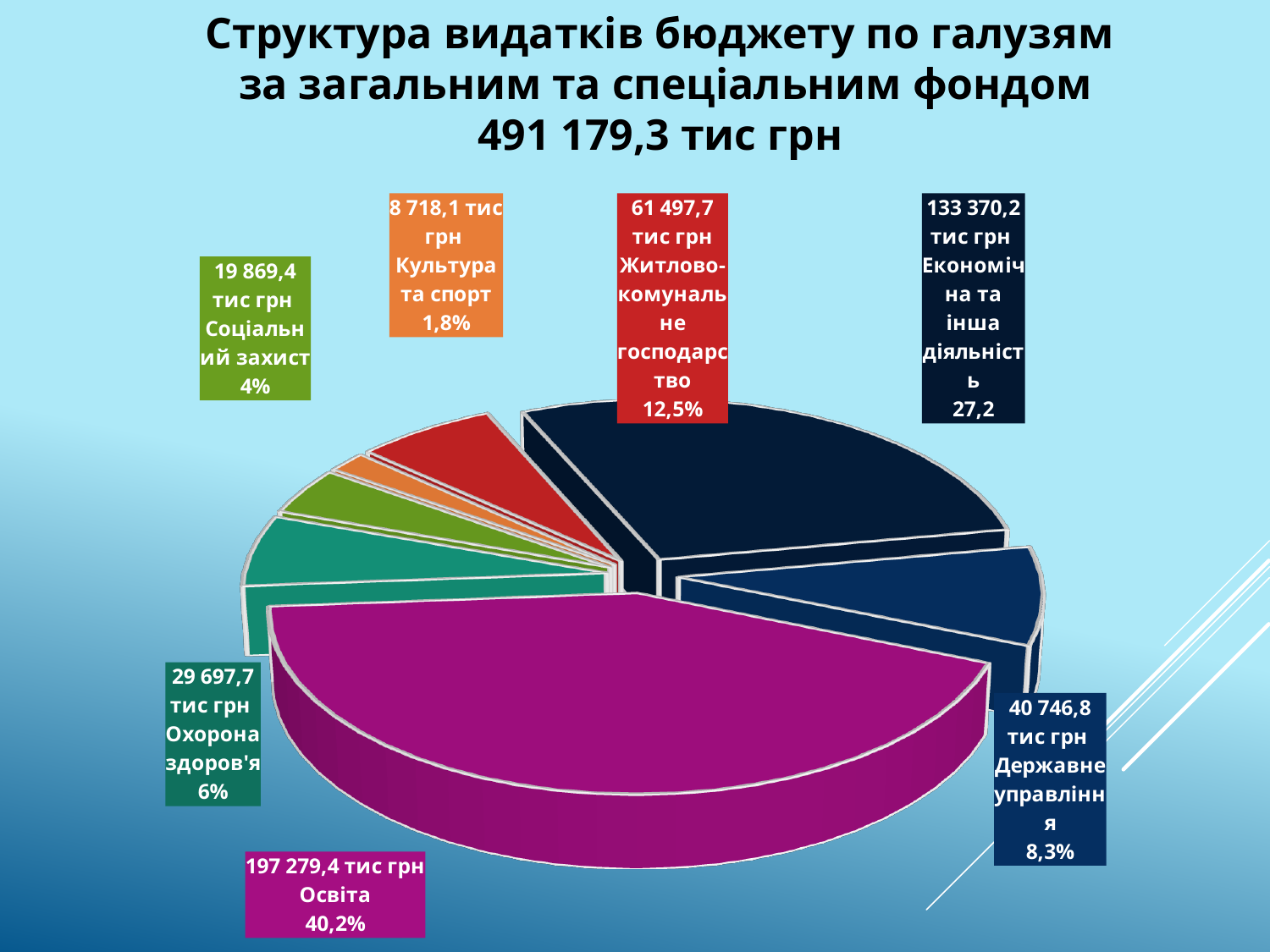
What is the value for Охорона здоров'я? 29 697,7 тис грн What kind of chart is shown on the slide? pie chart What is the value for Економічна та інша діяльність? 133 370,2 тис грн Which category has the largest slice of the pie? Освіта What is the difference between the shares of Освіта and Економічна та інша діяльність? 13 percentage points What share of the pie does Житлово-комунальне господарство represent? 12,5% Which is larger, Соціальний захист or Охорона здоров'я? Охорона здоров'я What is the value for Освіта? 197 279,4 тис грн Which labelled category has the smallest slice of the pie? Культура та спорт What is the value for Державне управління? 40 746,8 тис грн What share of the pie does Освіта represent? 40,2% What total amount is stated in the chart title? 491 179,3 тис грн